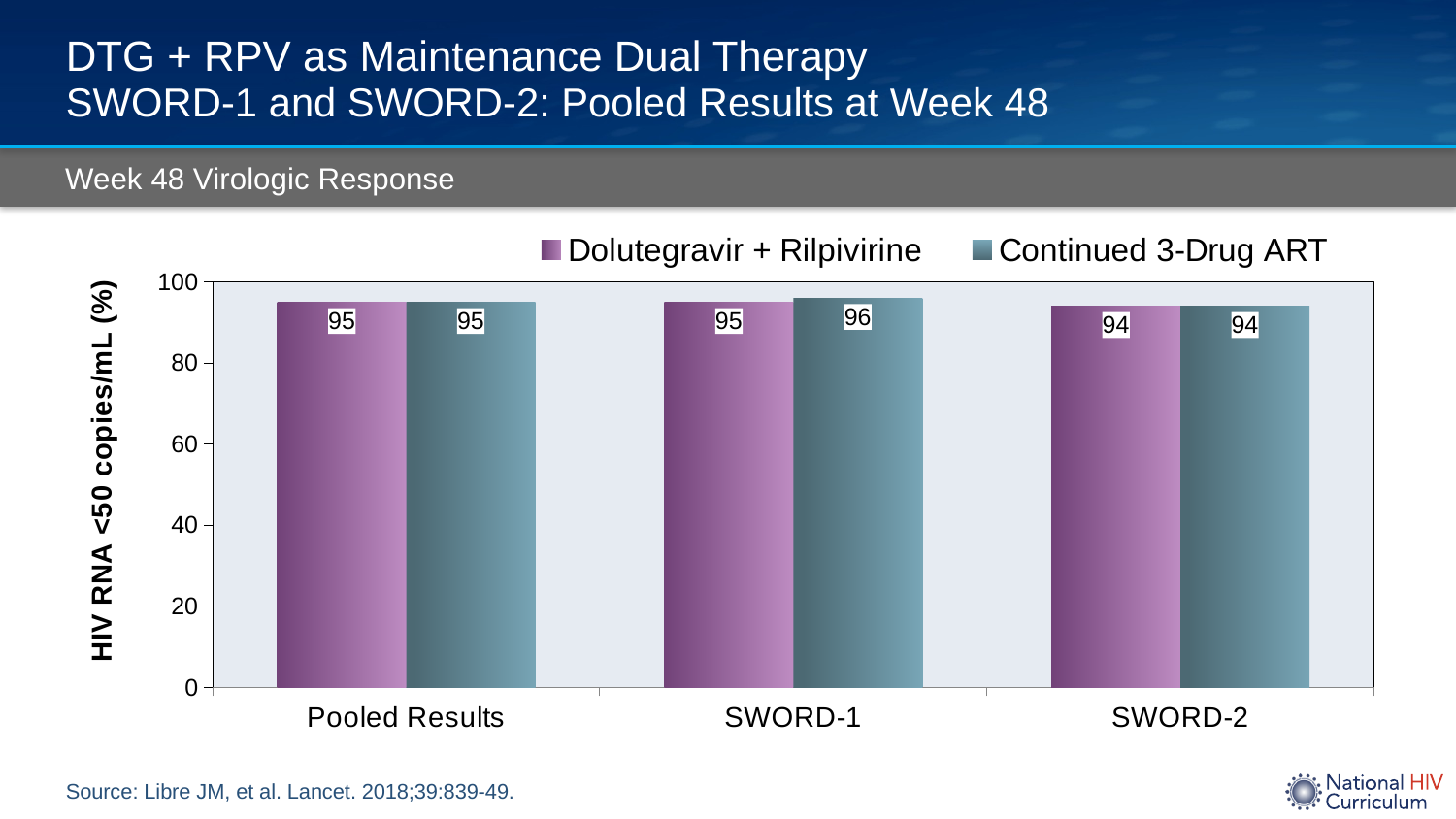
Is the value for Continued 3-Drug ART in SWORD-2 greater or less than 80? greater What is the value for Dolutegravir + Rilpivirine in the Pooled Results group? 95 How many series does the legend list? 2 What is the difference between the Dolutegravir + Rilpivirine value in Pooled Results and in SWORD-2? 1 What is the value for Continued 3-Drug ART in SWORD-2? 94 What kind of chart is shown on the slide? bar chart Which has the higher value in SWORD-1, Dolutegravir + Rilpivirine or Continued 3-Drug ART? Continued 3-Drug ART What is the value for Dolutegravir + Rilpivirine in SWORD-2? 94 How many categories are shown on the x axis? 3 What is the value for Continued 3-Drug ART in SWORD-1? 96 What is the difference between the Continued 3-Drug ART value and the Dolutegravir + Rilpivirine value in SWORD-1? 1 What is the label of the y axis? HIV RNA <50 copies/mL (%)